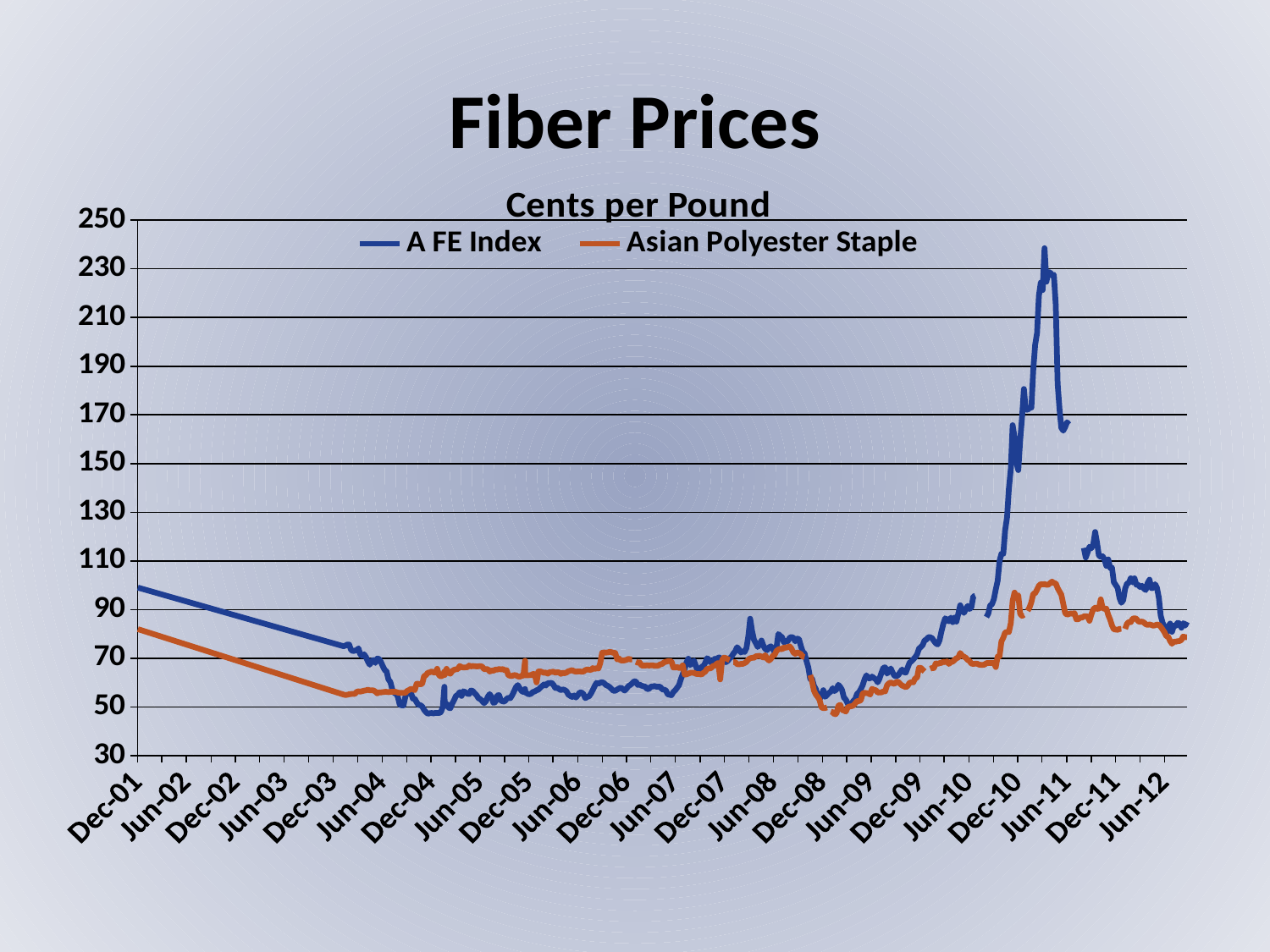
Is the value of Asian Polyester Staple at Dec-03 greater or less than 70? less Is the highest value reached by Asian Polyester Staple greater or less than 110? less Is the value of the A FE Index at Dec-01 greater or less than 90? greater At Dec-01, which series has the higher value, A FE Index or Asian Polyester Staple? A FE Index What is the title shown above the chart's plot area? Cents per Pound What are the two series named in the legend? A FE Index and Asian Polyester Staple Does the A FE Index rise or fall between Dec-01 and Dec-03? fall What kind of chart is shown on the slide? line chart Around Jun-11, which series has the higher value, A FE Index or Asian Polyester Staple? A FE Index How many series does the legend list? 2